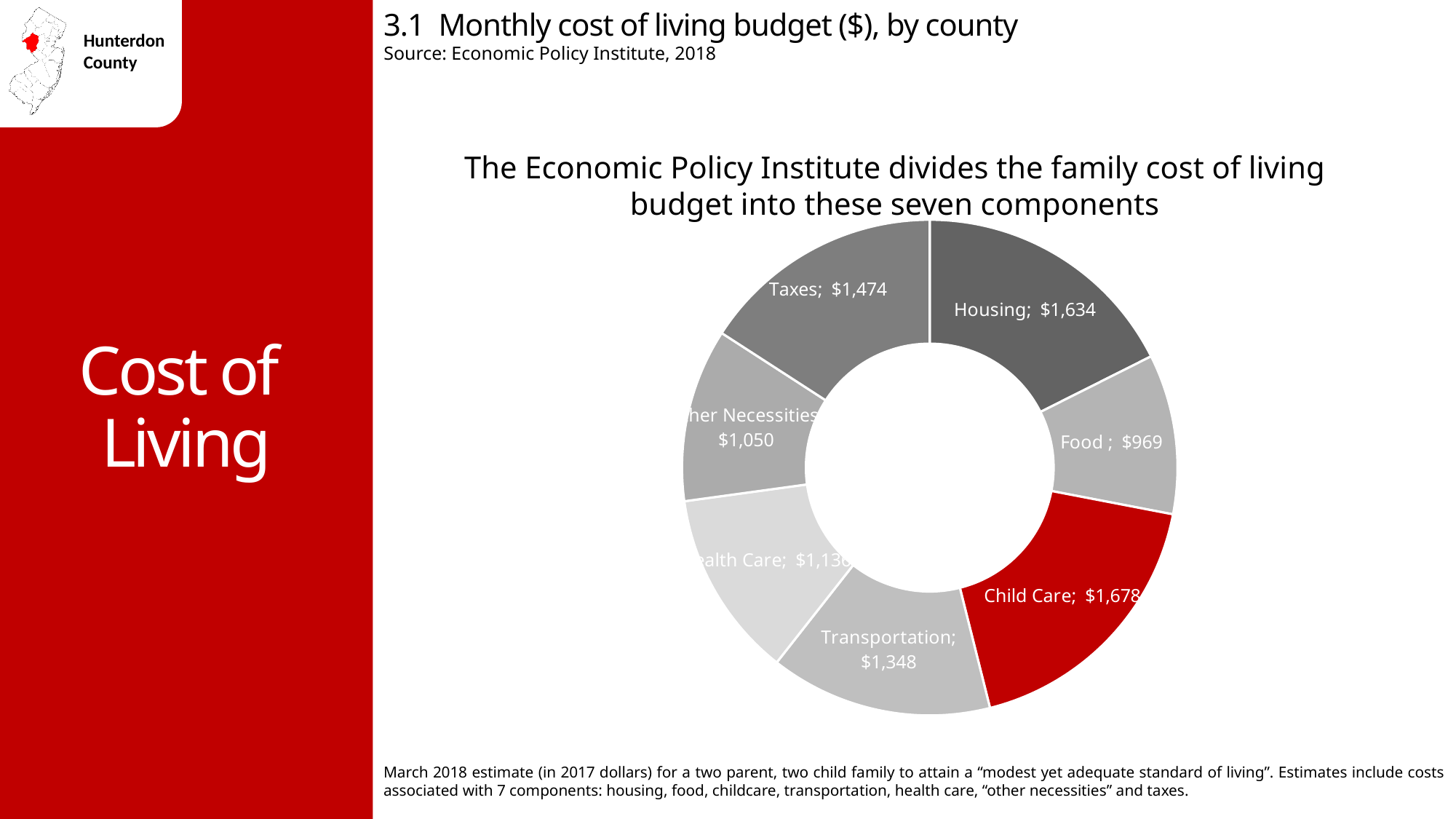
Which component has the lowest monthly cost? Food How much more is the Housing cost than the Food cost? $665 Which is larger, the Taxes value or the Transportation value? Taxes What is the monthly Food cost shown on the chart? $969 What is the difference between the Child Care cost and the Housing cost? $44 What is the monthly Child Care cost shown on the chart? $1,678 How many components are shown in the chart? 7 What is the monthly Transportation cost shown on the chart? $1,348 What kind of chart is shown on the slide? Doughnut chart Which component has the highest monthly cost? Child Care What is the monthly Taxes value shown on the chart? $1,474 What is the monthly Housing cost shown on the chart? $1,634